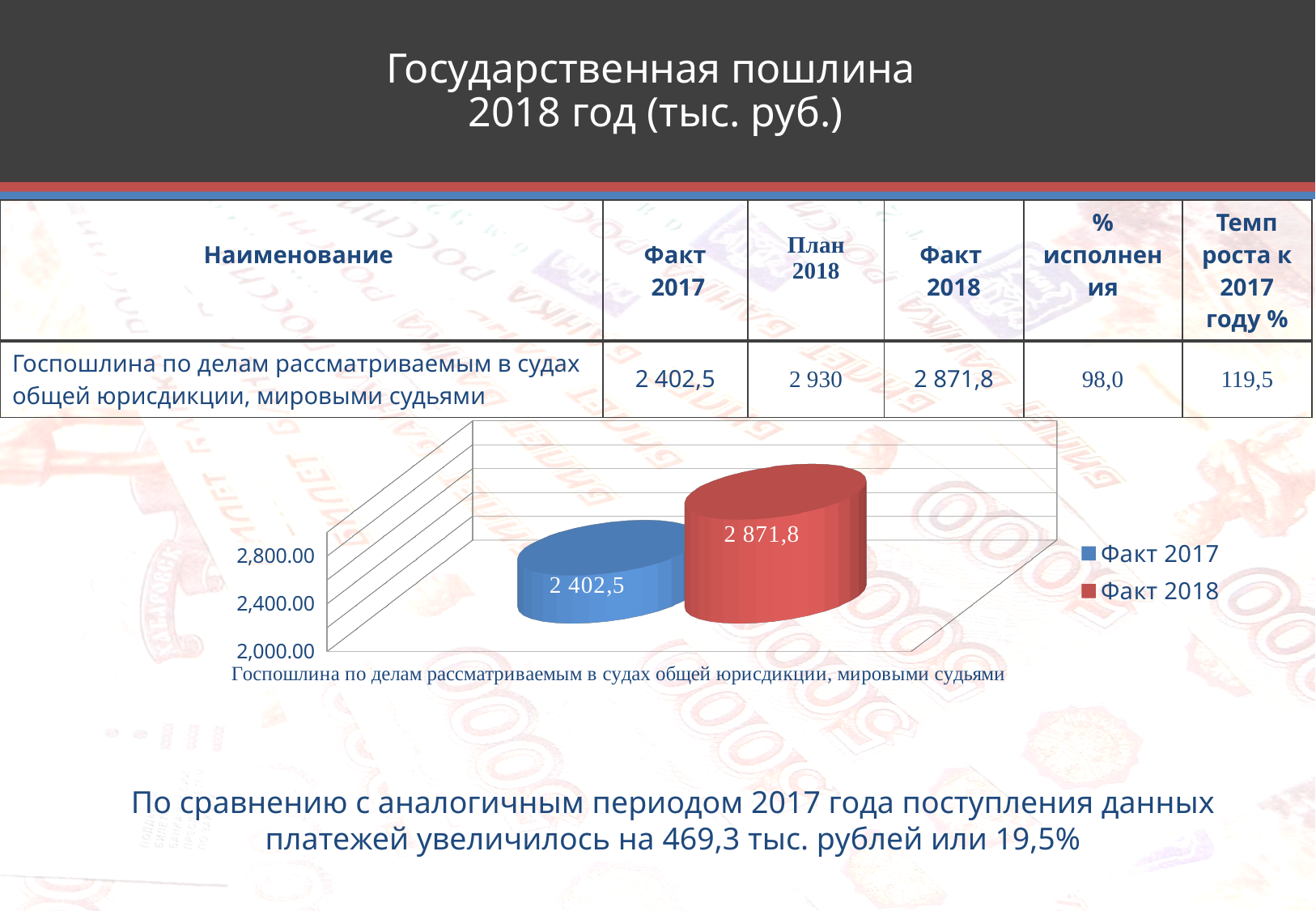
What colour represents Факт 2018 in the chart legend? red How many categories are shown on the x axis of the chart? 1 What is the difference between the Факт 2018 and Факт 2017 values in the chart? 469,3 Is the value for Факт 2017 greater or less than 2,800.00? less What is the value for Факт 2017 in the chart? 2 402,5 Which series has the lower value in the chart? Факт 2017 Which series has the higher value in the chart, Факт 2017 or Факт 2018? Факт 2018 What kind of chart is shown on the slide? bar chart Is the value for Факт 2018 greater or less than 2,400.00? greater Is the value for Факт 2017 larger or smaller than the value for Факт 2018? smaller What is the value for Факт 2018 in the chart? 2 871,8 How many series does the chart legend list? 2